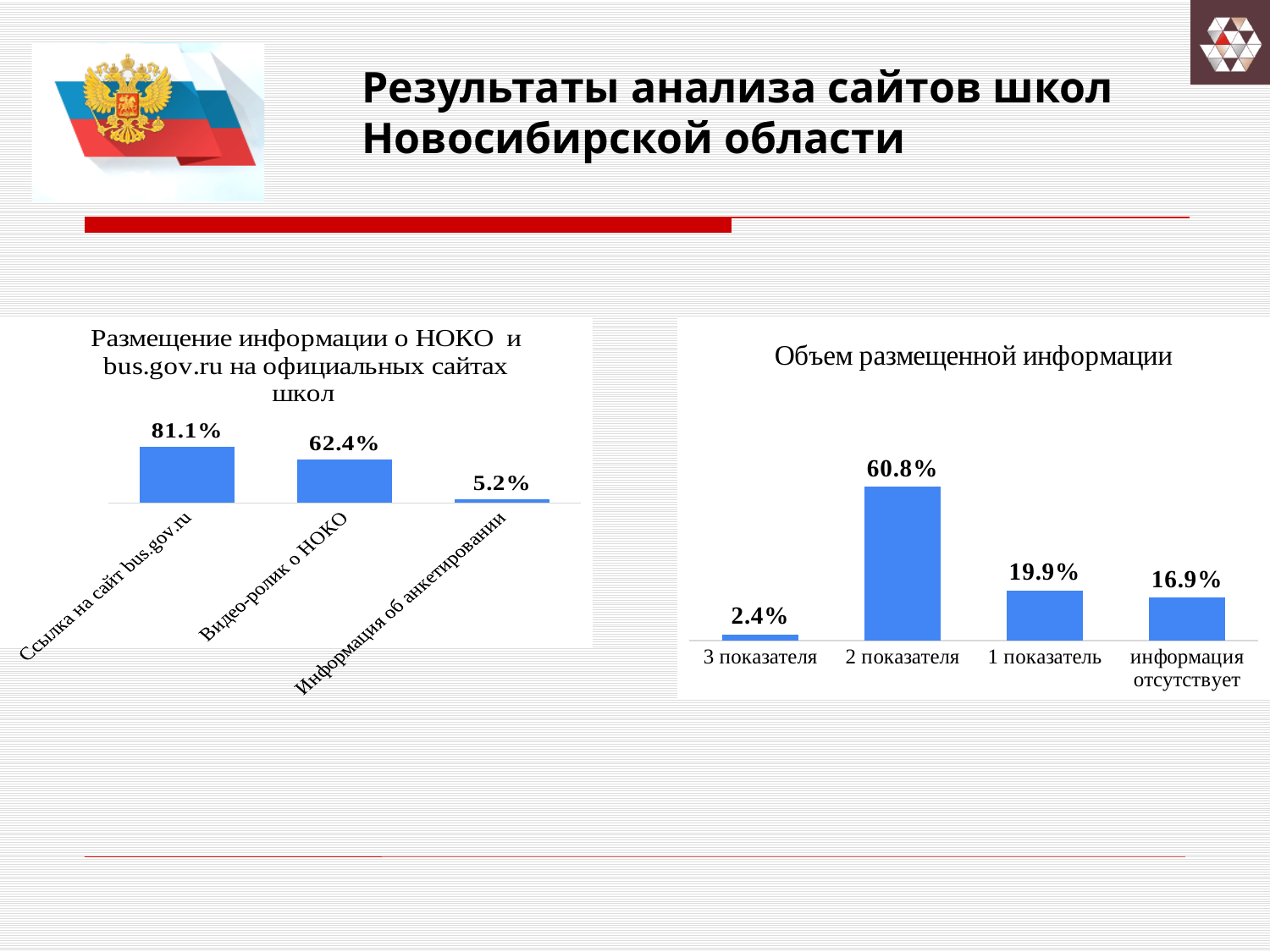
In the right chart (Объем размещенной информации), which category has the highest value? 2 показателя In the left chart (Размещение информации о НОКО и bus.gov.ru на официальных сайтах школ), how many categories are shown? 3 In the right chart (Объем размещенной информации), which is larger: 1 показатель or информация отсутствует? 1 показатель In the left chart (Размещение информации о НОКО и bus.gov.ru на официальных сайтах школ), which category has the lowest value? Информация об анкетировании In the right chart (Объем размещенной информации), what is the difference between 1 показатель and информация отсутствует? 3.0% In the left chart (Размещение информации о НОКО и bus.gov.ru на официальных сайтах школ), what is the value for Ссылка на сайт bus.gov.ru? 81.1% In the left chart (Размещение информации о НОКО и bus.gov.ru на официальных сайтах школ), what is the value for Видео-ролик о НОКО? 62.4% In the right chart (Объем размещенной информации), which category has the lowest value? 3 показателя In the left chart (Размещение информации о НОКО и bus.gov.ru на официальных сайтах школ), what is the difference between Ссылка на сайт bus.gov.ru and Видео-ролик о НОКО? 18.7% In the right chart (Объем размещенной информации), what is the value for 2 показателя? 60.8% What type of chart is the right chart (Объем размещенной информации)? Bar chart In the right chart (Объем размещенной информации), what is the value for информация отсутствует? 16.9%